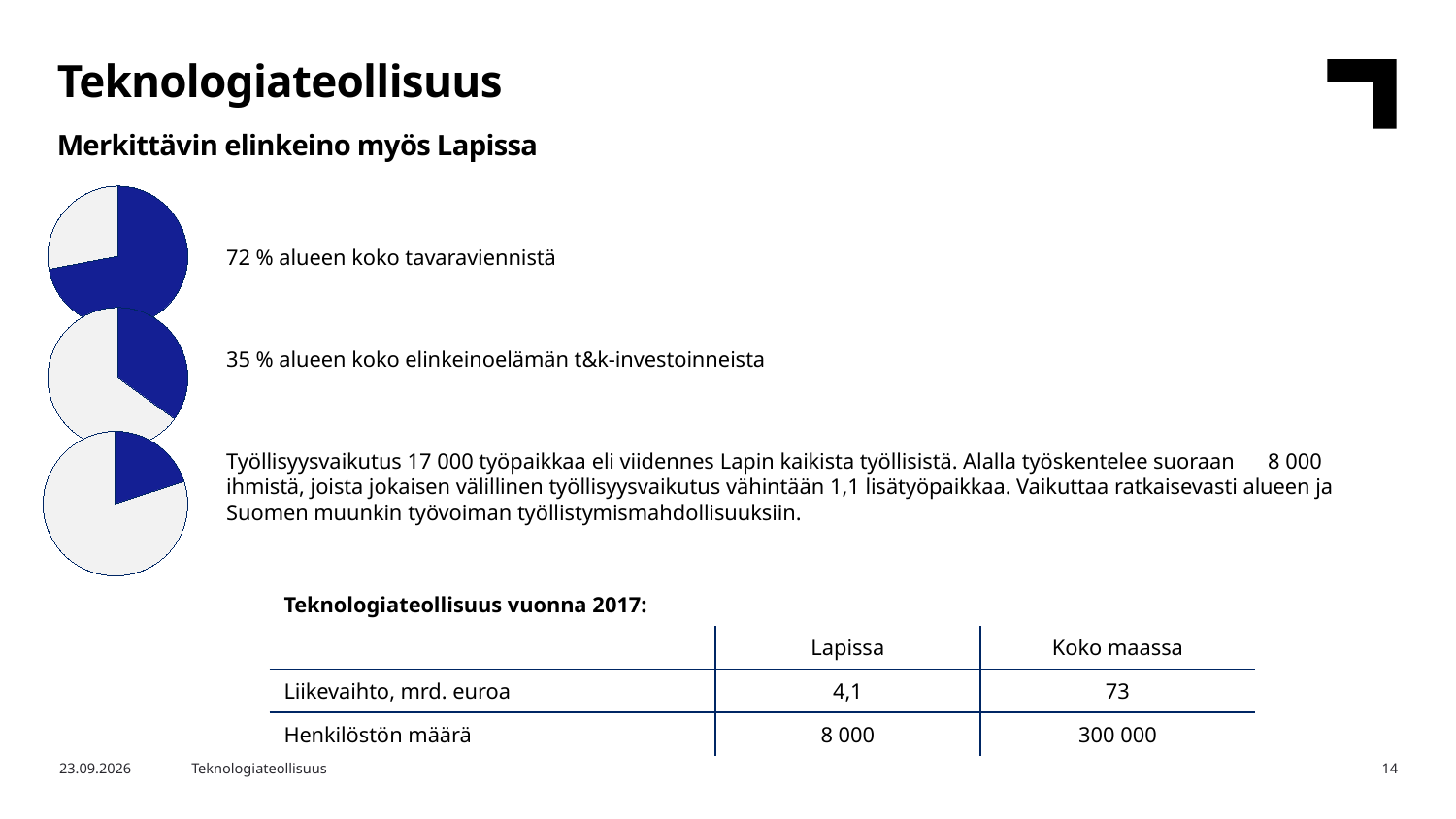
What colour is used for the highlighted slice in the pie charts? blue What is the difference in percentage points between the share shown for the top pie chart (72 %) and the middle pie chart (35 %)? 37 percentage points Which of the three pie charts has the largest highlighted slice? the top one (72 % alueen koko tavaraviennistä) How many pie charts are shown on the slide? 3 What kind of chart is the top chart on the left of the slide? pie chart What does the top pie chart represent, according to the text next to it? 72 % alueen koko tavaraviennistä What share of the top pie chart is taken by the highlighted (blue) slice? 72 % Which of the three pie charts has the smallest highlighted slice? the bottom one (työllisyysvaikutus) According to the label next to the top pie chart, what share of the region's total goods exports (alueen koko tavaraviennistä) does the highlighted slice represent? 72 % Which pie chart has the larger highlighted slice, the middle one (t&k-investoinnit) or the bottom one (työllisyysvaikutus)? the middle one (t&k-investoinnit) According to the label next to the middle pie chart, what share of the region's business R&D investments (elinkeinoelämän t&k-investoinneista) does the highlighted slice represent? 35 % Which pie chart has the larger highlighted slice, the top one (tavaravienti) or the middle one (t&k-investoinnit)? the top one (tavaravienti)